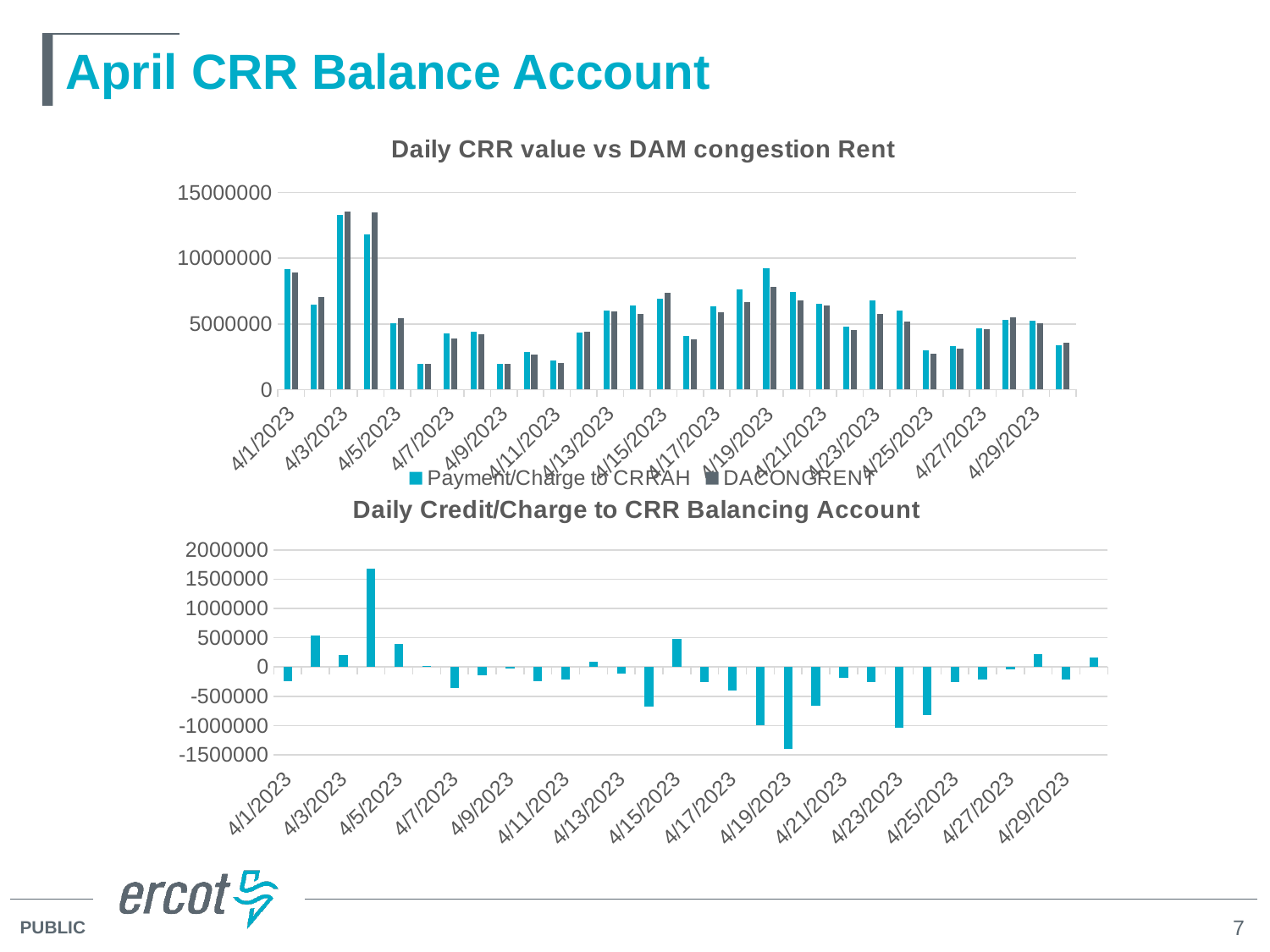
In the top chart, 'Daily CRR value vs DAM congestion Rent', which is larger on 4/4/2023: Payment/Charge to CRRAH or DACONGRENT? DACONGRENT How many series does the legend of the top chart, 'Daily CRR value vs DAM congestion Rent', list? 2 In the bottom chart, 'Daily Credit/Charge to CRR Balancing Account', is the value for 4/4/2023 greater or less than 1500000? greater In the top chart, 'Daily CRR value vs DAM congestion Rent', on which date is the Payment/Charge to CRRAH value highest? 4/3/2023 In the top chart, 'Daily CRR value vs DAM congestion Rent', is the Payment/Charge to CRRAH value for 4/1/2023 greater or less than 5000000? greater In the bottom chart, 'Daily Credit/Charge to CRR Balancing Account', on which date is the value highest? 4/4/2023 In the top chart, 'Daily CRR value vs DAM congestion Rent', what are the two series named in the legend? Payment/Charge to CRRAH and DACONGRENT What kind of chart is the top chart, 'Daily CRR value vs DAM congestion Rent'? bar chart In the top chart, 'Daily CRR value vs DAM congestion Rent', is the Payment/Charge to CRRAH value for 4/4/2023 greater or less than 10000000? greater In the bottom chart, 'Daily Credit/Charge to CRR Balancing Account', on which date is the value lowest? 4/19/2023 What is the title of the bottom chart on the slide? Daily Credit/Charge to CRR Balancing Account